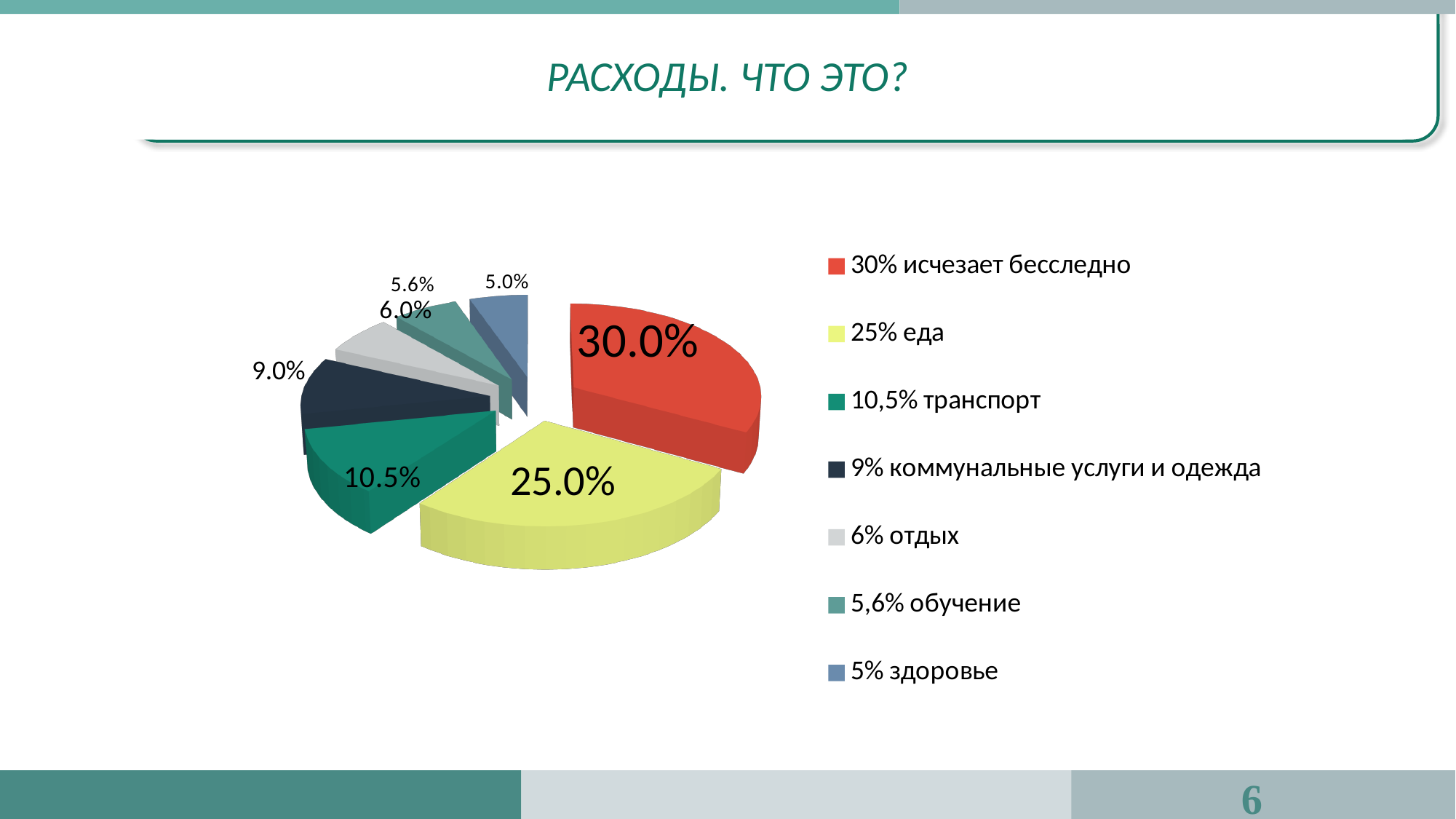
Which category has the smallest slice of the pie? здоровье What kind of chart is shown on the slide? pie chart What colour is the slice for "еда"? yellow What is the data label on the slice for "обучение"? 5.6% Which category has the largest slice of the pie? исчезает бесследно What is the title of the slide containing the pie chart? РАСХОДЫ. ЧТО ЭТО? Which is larger, the slice for "коммунальные услуги и одежда" or the slice for "отдых"? коммунальные услуги и одежда What is the data label on the slice for "здоровье"? 5.0% What is the difference between the slice for "исчезает бесследно" and the slice for "еда"? 5.0% How many slices does the pie chart have? 7 What is the data label on the slice for "транспорт"? 10.5% What is the data label on the slice for "еда"? 25.0%